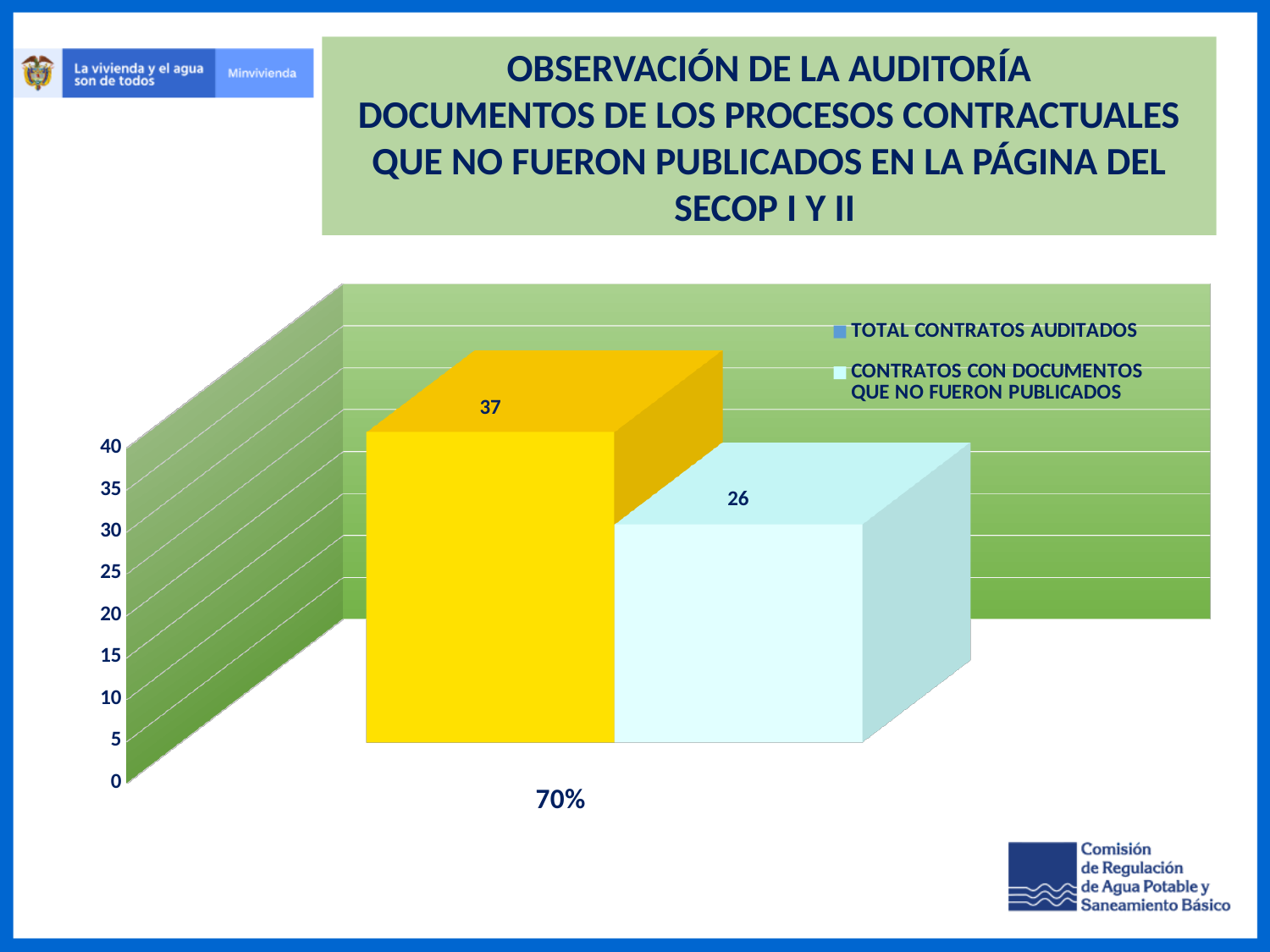
What is the difference between TOTAL CONTRATOS AUDITADOS and CONTRATOS CON DOCUMENTOS QUE NO FUERON PUBLICADOS? 11 Which series has the lower value? CONTRATOS CON DOCUMENTOS QUE NO FUERON PUBLICADOS What is the value for CONTRATOS CON DOCUMENTOS QUE NO FUERON PUBLICADOS? 26 Which series has the higher value? TOTAL CONTRATOS AUDITADOS What is the maximum value shown on the vertical axis? 40 Is the value for TOTAL CONTRATOS AUDITADOS greater or less than 35? greater Is the value for CONTRATOS CON DOCUMENTOS QUE NO FUERON PUBLICADOS greater or less than 30? less How many series does the legend list? 2 Is the value for TOTAL CONTRATOS AUDITADOS larger or smaller than the value for CONTRATOS CON DOCUMENTOS QUE NO FUERON PUBLICADOS? larger What percentage label is shown below the bars? 70% What kind of chart is shown on the slide? bar chart What is the value for TOTAL CONTRATOS AUDITADOS? 37